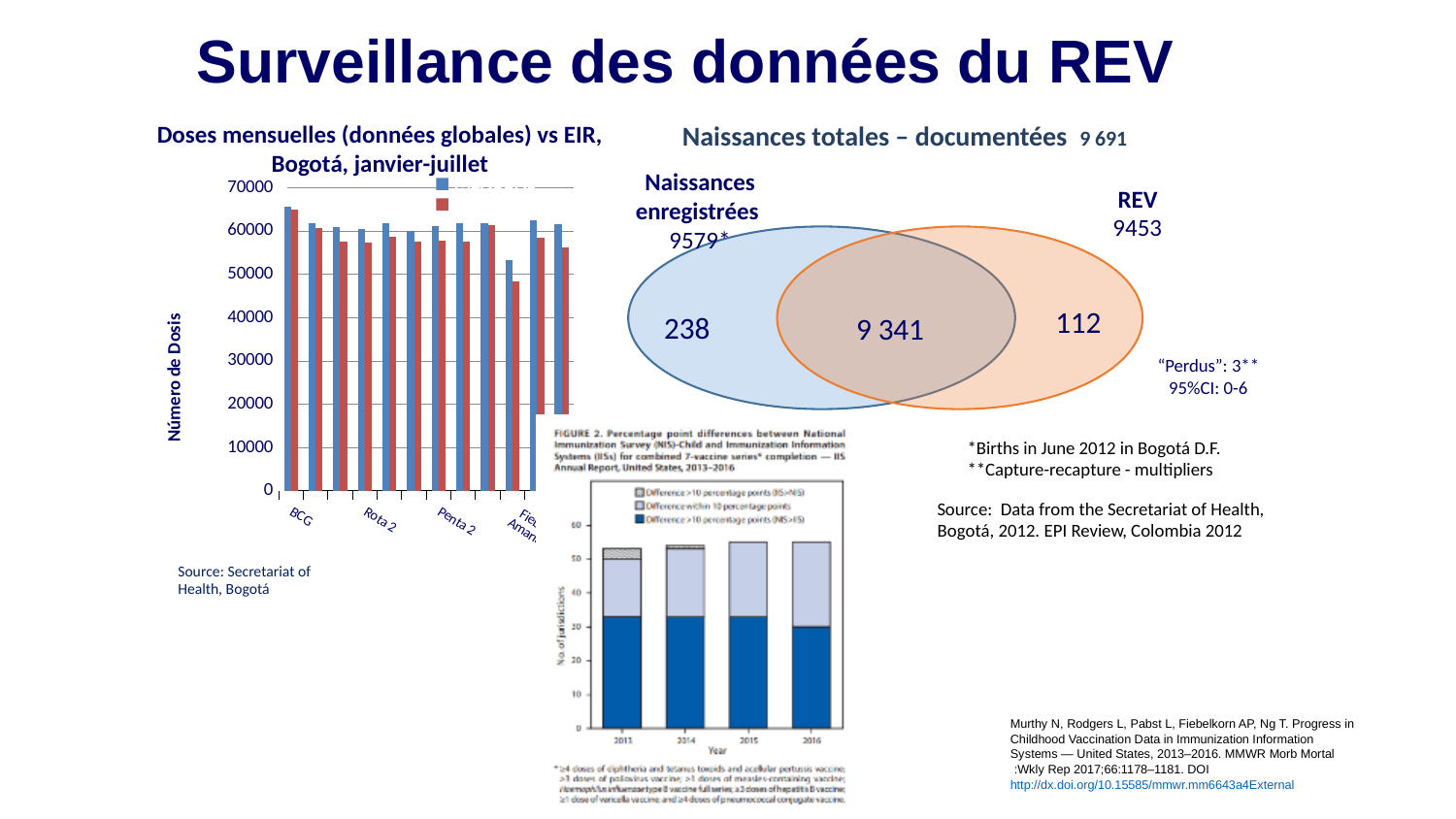
In the 'Naissances totales – documentées' diagram, what value is shown in the overlap of the two circles? 9 341 In the 'FIGURE 2' stacked bar chart, is the total height of the 2016 bar greater or less than 50? greater In the 'Doses mensuelles' bar chart, is the value of the red bar for Rota 2 greater or less than 60000? less What kind of chart is the embedded 'FIGURE 2' chart at the bottom centre of the slide? stacked bar chart In the 'Doses mensuelles' bar chart, is the value of the blue bar for Penta 2 greater or less than 50000? greater What kind of chart is the 'Doses mensuelles (données globales) vs EIR, Bogotá, janvier-juillet' chart? bar chart In the 'Doses mensuelles' bar chart, what is the highest value shown on the y axis? 70000 In the 'Doses mensuelles' bar chart, how many bar colours (series) are plotted? 2 In the 'FIGURE 2' stacked bar chart, how many entries does the legend list? 3 In the 'FIGURE 2' stacked bar chart, how many years are shown on the x axis? 4 In the 'Doses mensuelles' bar chart, what is the label of the y axis? Número de Dosis